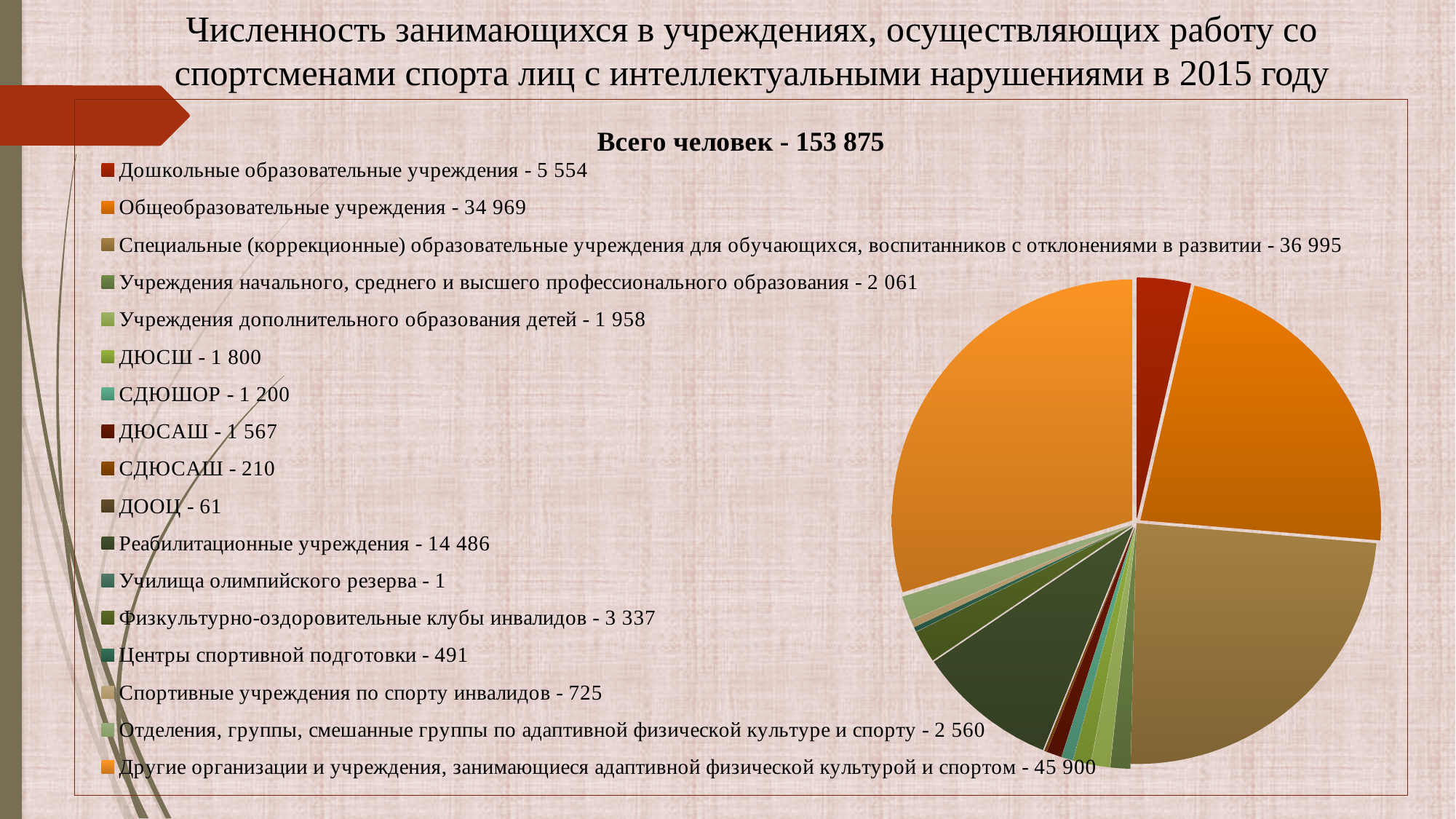
How many categories does the pie chart have? 17 What is the difference between the values for Реабилитационные учреждения and Дошкольные образовательные учреждения? 8 932 Which category has the lowest value? Училища олимпийского резерва What is the value for Общеобразовательные учреждения? 34 969 Which category has the highest value? Другие организации и учреждения, занимающиеся адаптивной физической культурой и спортом Which is larger, the value for ДЮСШ or the value for СДЮШОР? ДЮСШ What is the difference between the values for Специальные (коррекционные) образовательные учреждения and Общеобразовательные учреждения? 2 026 What is the value for Реабилитационные учреждения? 14 486 What type of chart is shown on the slide? Pie chart What is the value for ДЮСАШ? 1 567 What total number of people is stated above the chart? 153 875 What is the value for Центры спортивной подготовки? 491